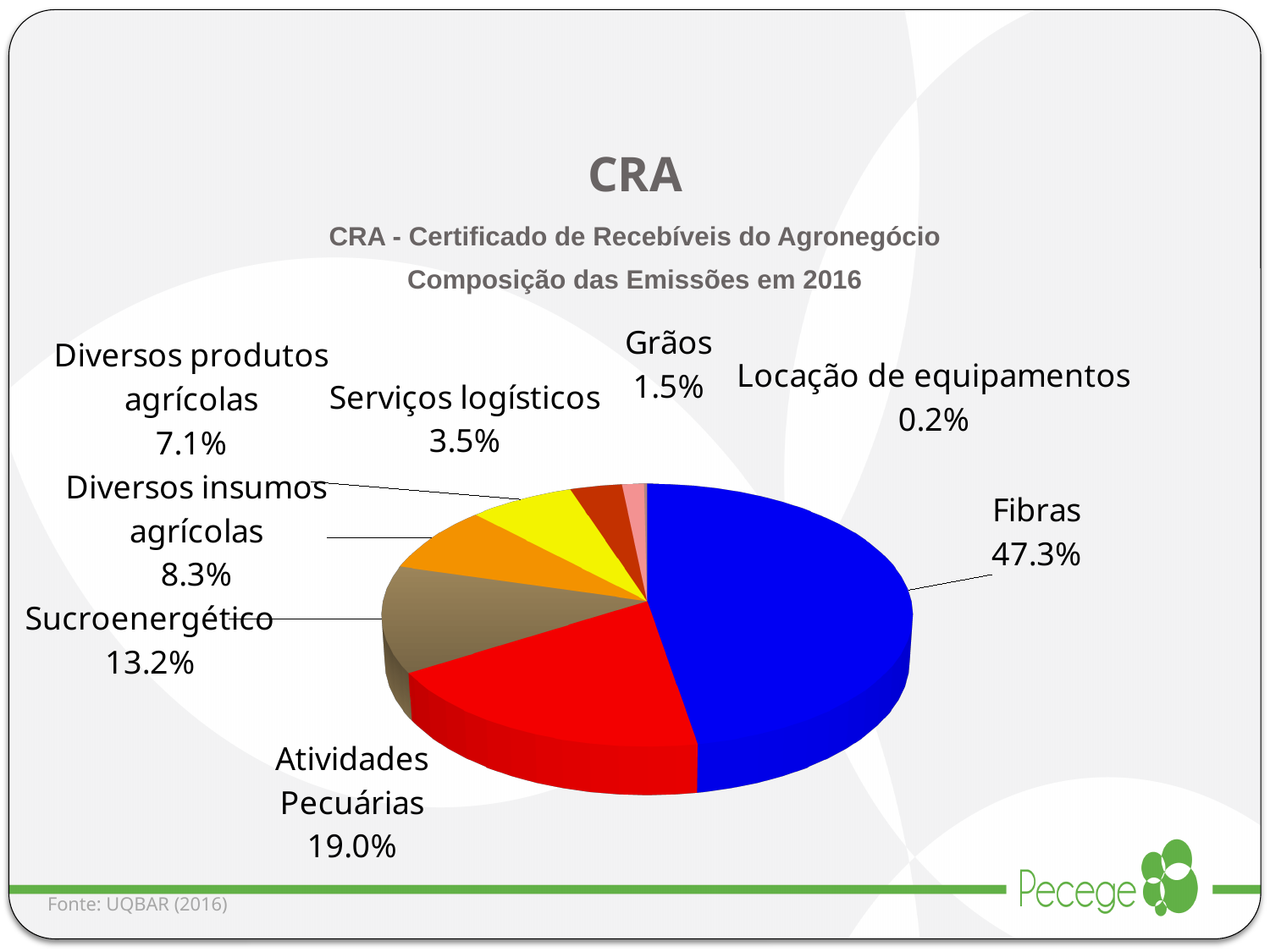
What kind of chart is shown on the slide? Pie chart What is the value for Diversos insumos agrícolas? 8.3% Which category has the smallest slice of the pie? Locação de equipamentos Which is larger, Diversos produtos agrícolas or Diversos insumos agrícolas? Diversos insumos agrícolas What is the value shown for Atividades Pecuárias? 19.0% What share of CRA emissions in 2016 does Fibras account for? 47.3% What share is shown for Locação de equipamentos? 0.2% What is the source cited for the chart? UQBAR (2016) What percentage is shown for Sucroenergético? 13.2% What is the difference in percentage points between Fibras and Atividades Pecuárias? 28.3 Which category has the largest slice of the pie? Fibras How many categories are shown in the pie chart? 8